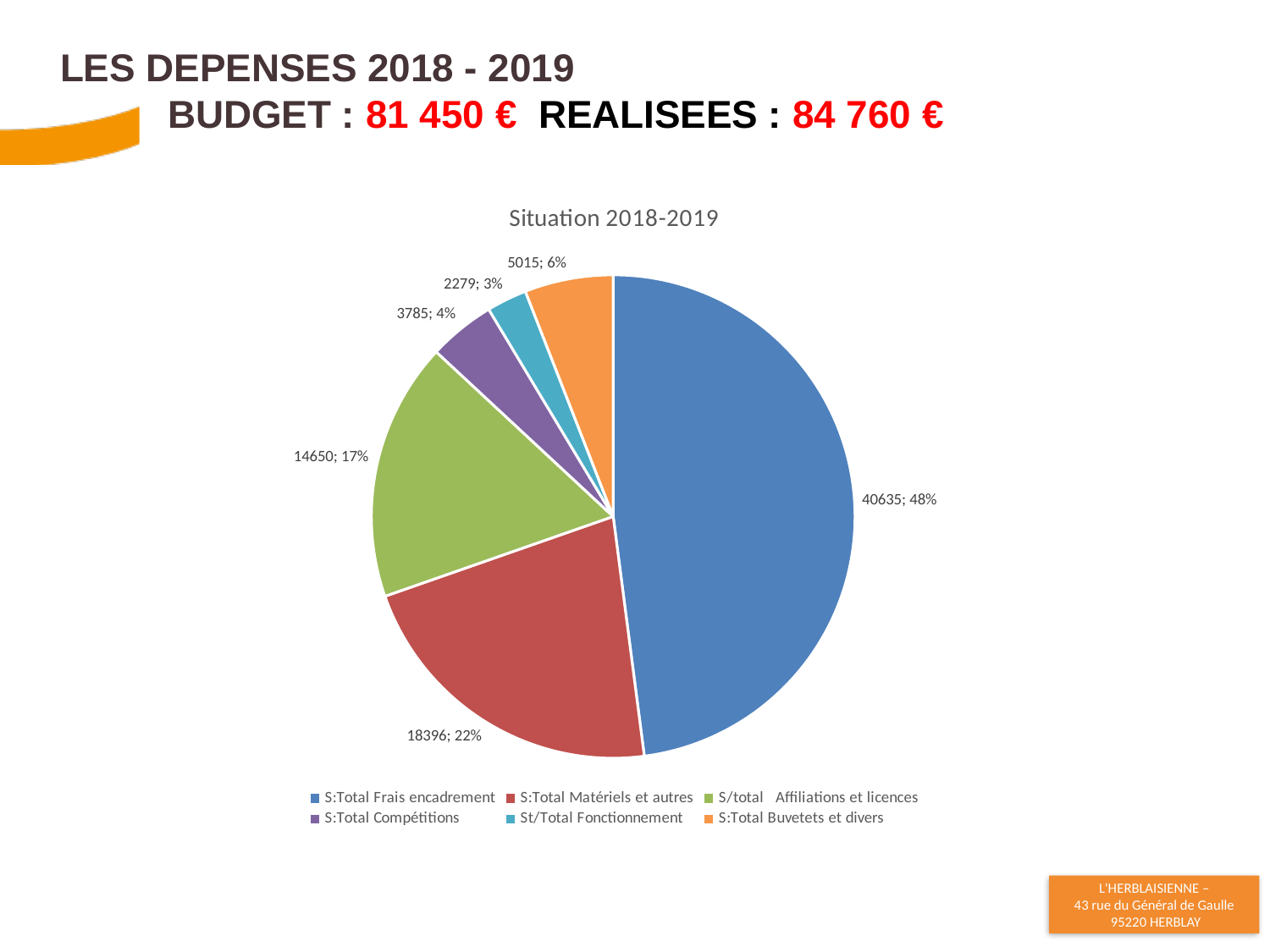
What percentage share does St/Total Fonctionnement have? 3% What percentage share does S:Total Matériels et autres have? 22% How many slices does the pie chart have? 6 Which category has the largest slice? S:Total Frais encadrement What kind of chart is shown on the slide? pie chart What value is shown for S:Total Frais encadrement? 40635 Which category has the smallest slice? St/Total Fonctionnement What is the title of the chart? Situation 2018-2019 How many entries does the legend list? 6 Which is larger, the value for S:Total Buvetets et divers or S:Total Compétitions? S:Total Buvetets et divers What is the difference between the values for S:Total Matériels et autres and S/total Affiliations et licences? 3746 What value is shown for S/total Affiliations et licences? 14650